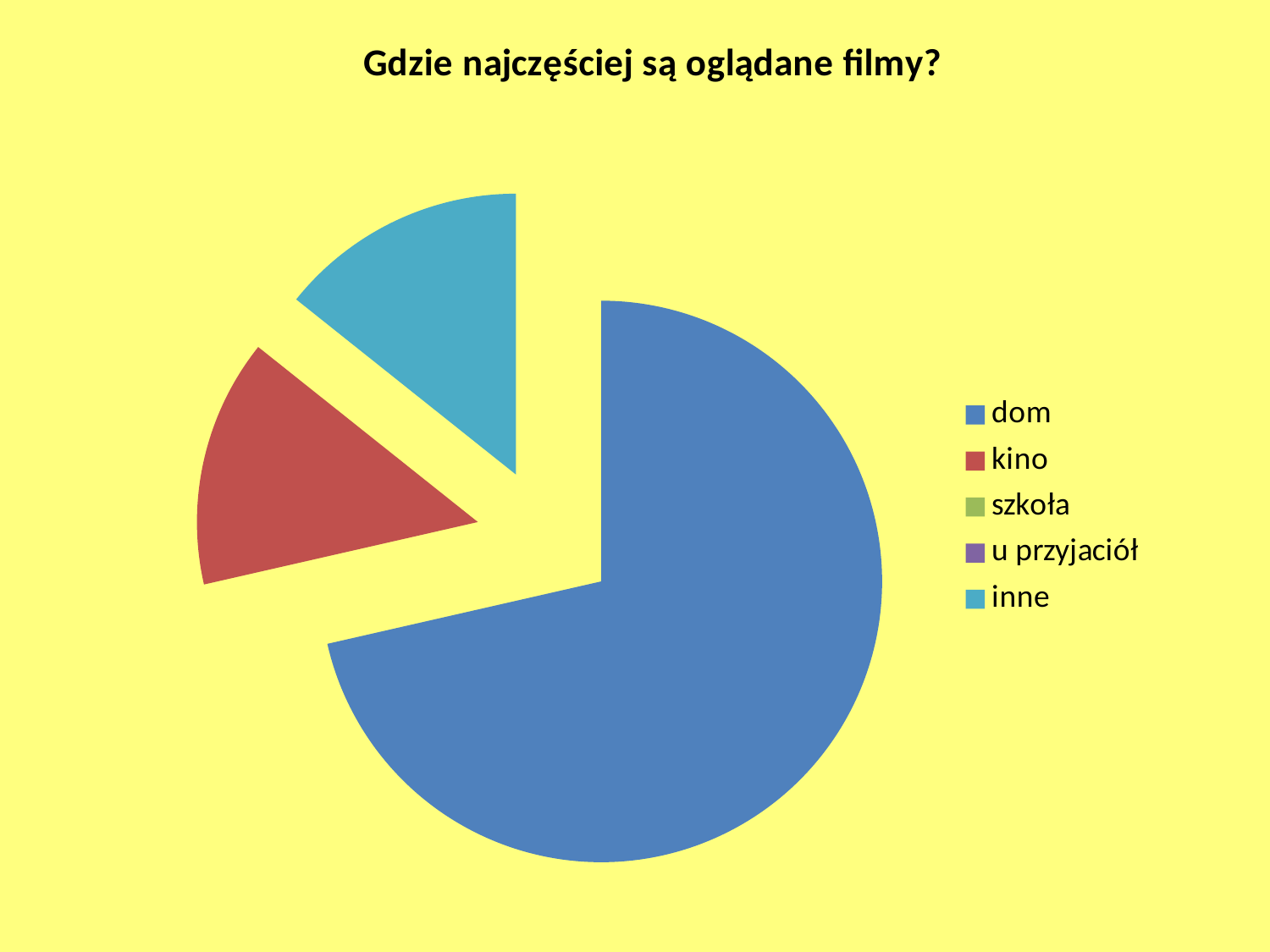
Which is larger, the slice for dom or the slice for inne? dom What kind of chart is shown on the slide? pie chart Does the slice for dom account for more or less than half of the pie? more How many slices are visible in the pie? 3 What is the title of the chart? Gdzie najczęściej są oglądane filmy? Which legend entries have no visible slice in the pie? szkoła and u przyjaciół How many entries does the legend list? 5 Which category has the largest slice of the pie? dom What colour is the slice for kino? red Which is larger, the slice for dom or the slice for kino? dom